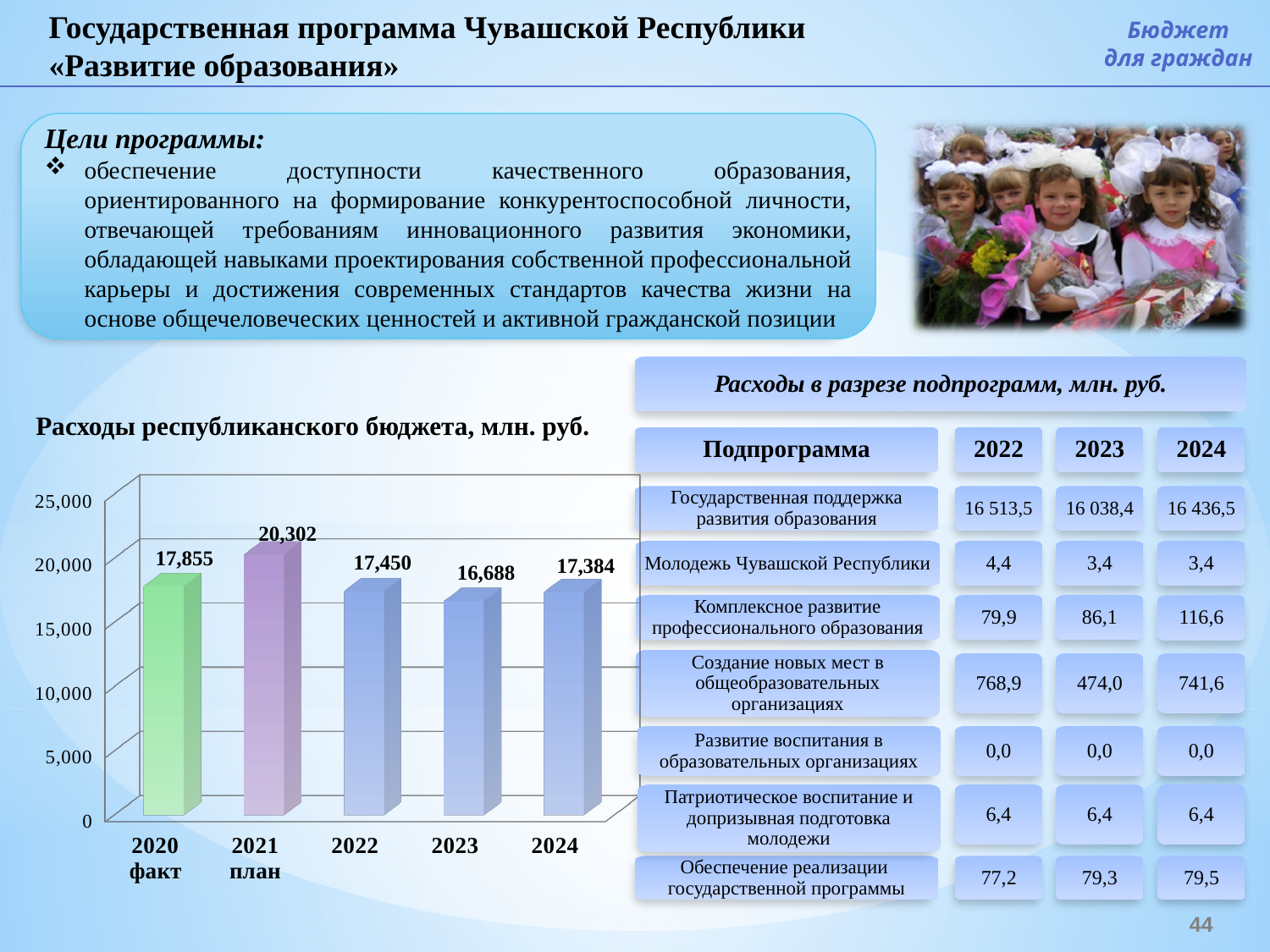
In the chart 'Расходы республиканского бюджета, млн. руб.', what is the difference between the 2022 and 2023 values? 762 What kind of chart is 'Расходы республиканского бюджета, млн. руб.'? bar chart Which year has the highest value in the chart 'Расходы республиканского бюджета, млн. руб.'? 2021 In the chart 'Расходы республиканского бюджета, млн. руб.', is the value for 2021 greater or less than 20,000? greater What is the value for 2021 план in the chart 'Расходы республиканского бюджета, млн. руб.'? 20,302 How many bars are shown in the chart 'Расходы республиканского бюджета, млн. руб.'? 5 Which year has the lowest value in the chart 'Расходы республиканского бюджета, млн. руб.'? 2023 In the chart 'Расходы республиканского бюджета, млн. руб.', which is larger: the value for 2022 or the value for 2024? 2022 In the chart 'Расходы республиканского бюджета, млн. руб.', do the values rise or fall from 2021 to 2023? fall In the chart 'Расходы республиканского бюджета, млн. руб.', what is the difference between the 2021 and 2020 values? 2,447 What is the value for 2020 факт in the chart 'Расходы республиканского бюджета, млн. руб.'? 17,855 What is the value for 2023 in the chart 'Расходы республиканского бюджета, млн. руб.'? 16,688